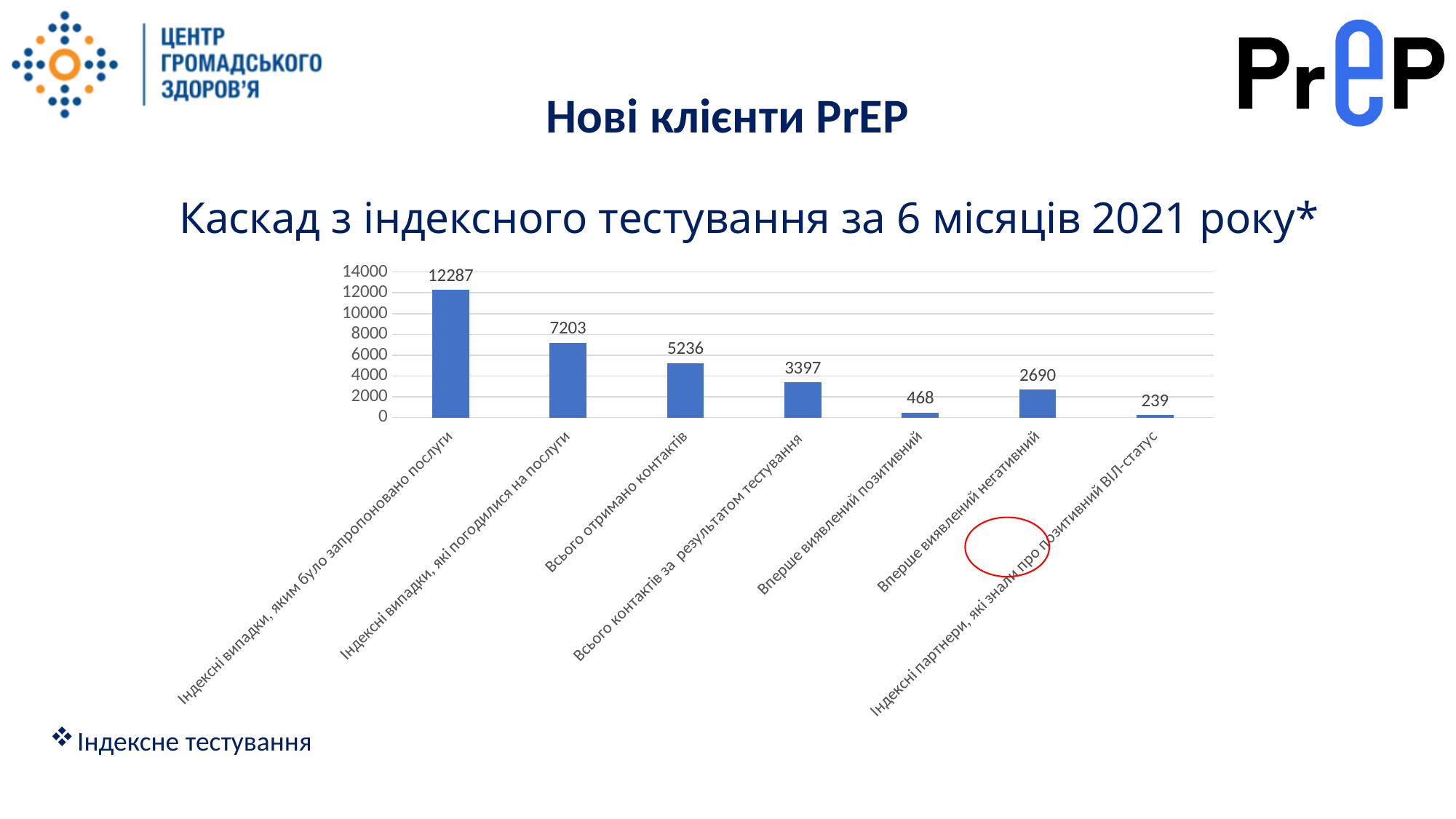
What is the difference between "Вперше виявлений негативний" and "Вперше виявлений позитивний"? 2222 What is the title of the chart? Каскад з індексного тестування за 6 місяців 2021 року* What kind of chart is shown on the slide? bar chart Which is larger: "Всього контактів за результатом тестування" or "Вперше виявлений негативний"? Всього контактів за результатом тестування What is the value for "Індексні випадки, яким було запропоновано послуги"? 12287 What is the value for "Вперше виявлений позитивний"? 468 How many categories are shown in the chart? 7 What is the value for "Індексні партнери, які знали про позитивний ВІЛ-статус"? 239 What is the value for "Всього отримано контактів"? 5236 Which category has the lowest value? Індексні партнери, які знали про позитивний ВІЛ-статус Which category has the highest value? Індексні випадки, яким було запропоновано послуги What is the difference between "Індексні випадки, яким було запропоновано послуги" and "Індексні випадки, які погодилися на послуги"? 5084